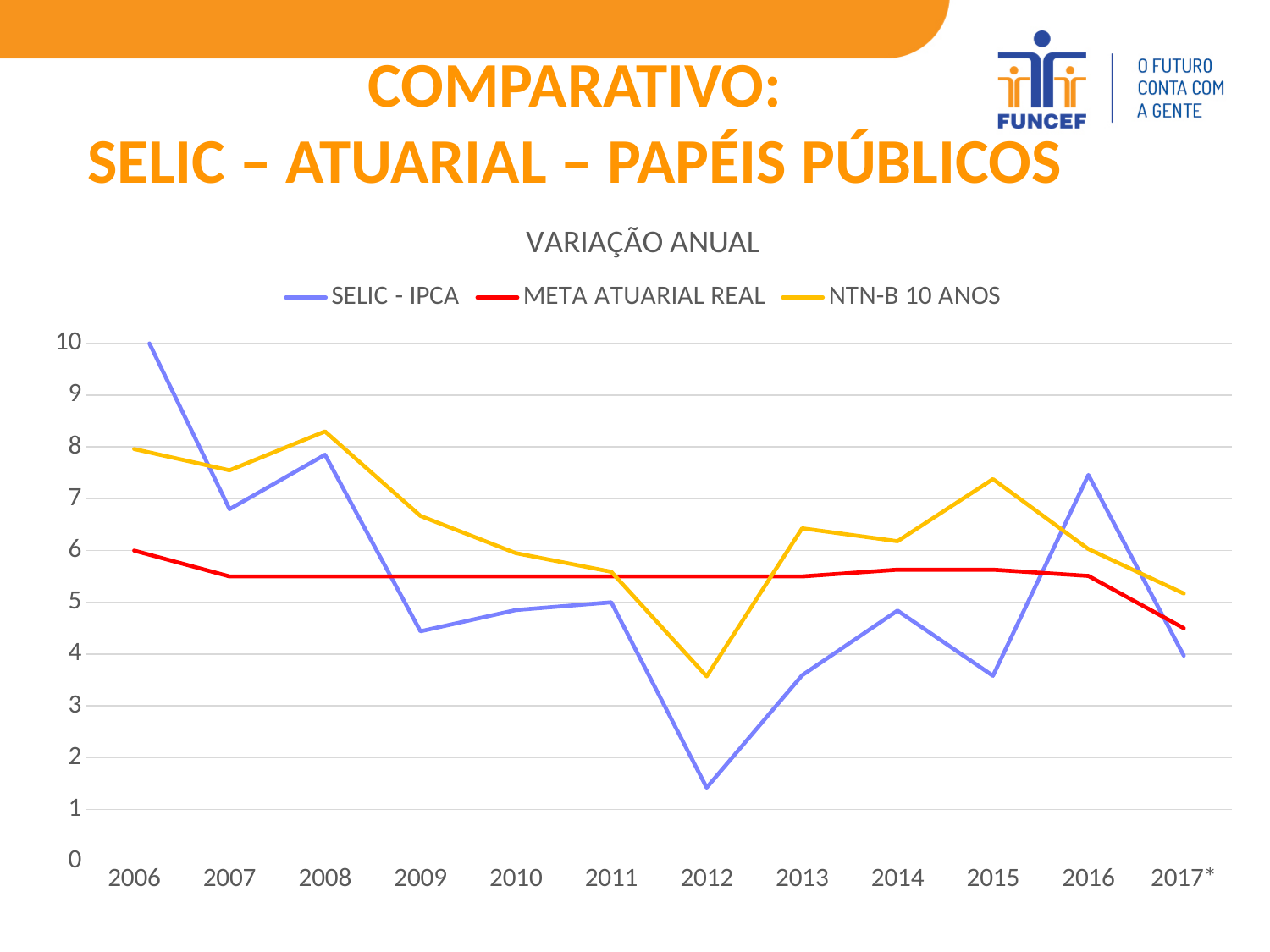
In which year is the SELIC - IPCA series at its highest? 2006 What kind of chart is shown on the slide? line chart Is the NTN-B 10 ANOS value for 2015 greater or less than 7? greater What is the title of the chart? VARIAÇÃO ANUAL Is the SELIC - IPCA value for 2012 greater or less than 2? less In which year is the NTN-B 10 ANOS series at its highest? 2008 In which year is the NTN-B 10 ANOS series at its lowest? 2012 How many years are shown along the x axis? 12 How many series does the legend list? 3 In which year is the SELIC - IPCA series at its lowest? 2012 In 2009, which series is higher: META ATUARIAL REAL or SELIC - IPCA? META ATUARIAL REAL In 2016, which series is higher: SELIC - IPCA or NTN-B 10 ANOS? SELIC - IPCA